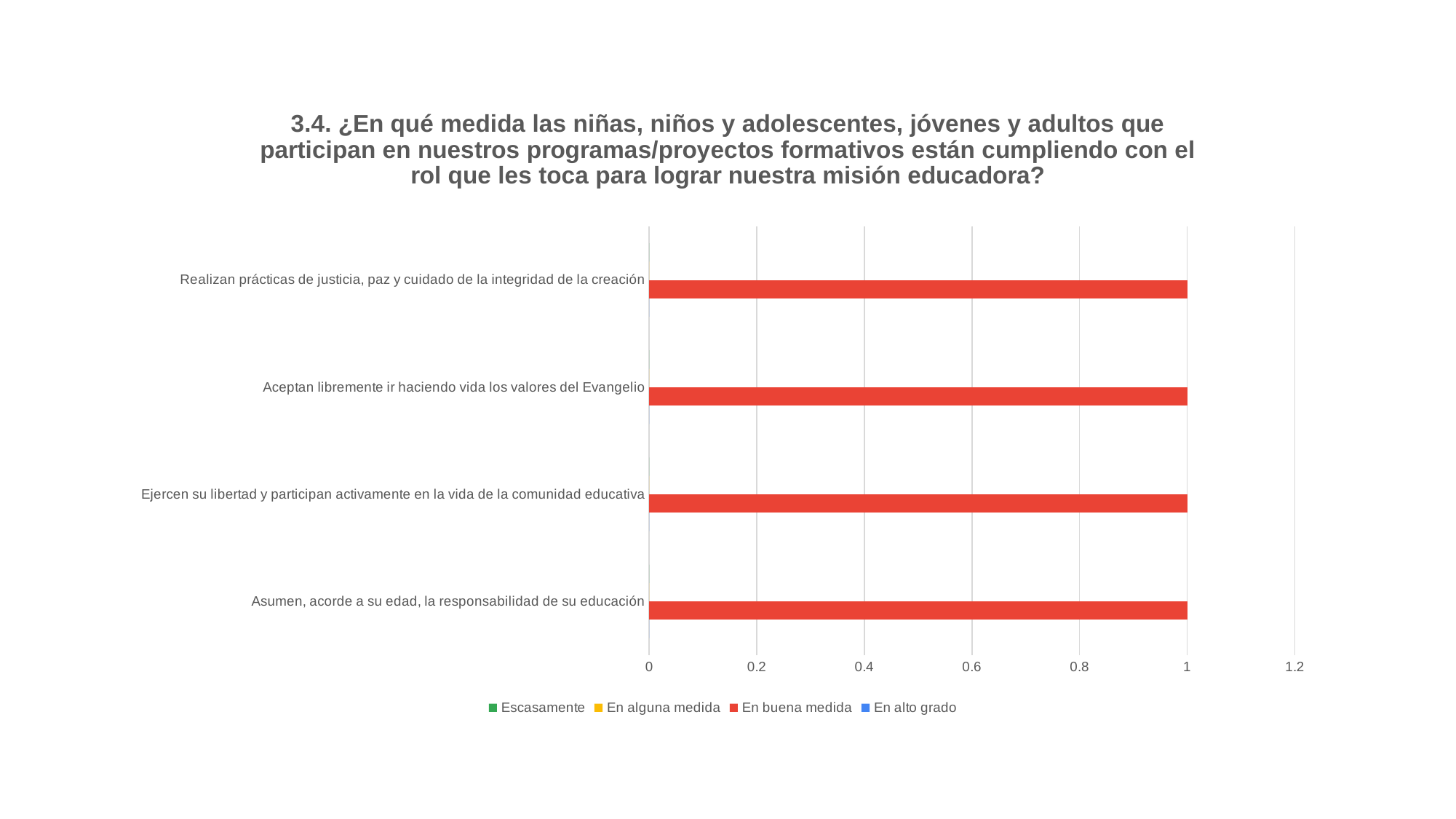
What is the value of "En buena medida" for "Aceptan libremente ir haciendo vida los valores del Evangelio"? 1 Is the "En buena medida" value for "Ejercen su libertad y participan activamente en la vida de la comunidad educativa" greater or less than 0.8? greater Is the "En buena medida" value for "Aceptan libremente ir haciendo vida los valores del Evangelio" greater or less than 0.6? greater How many series does the legend list? 4 What is the difference between the "En buena medida" values for "Realizan prácticas de justicia, paz y cuidado de la integridad de la creación" and "Asumen, acorde a su edad, la responsabilidad de su educación"? 0 How many categories are plotted on the chart? 4 What is the value of "En buena medida" for "Realizan prácticas de justicia, paz y cuidado de la integridad de la creación"? 1 What is the highest value shown on the horizontal axis? 1.2 What is the value of "En buena medida" for "Asumen, acorde a su edad, la responsabilidad de su educación"? 1 What is the value of "En buena medida" for "Ejercen su libertad y participan activamente en la vida de la comunidad educativa"? 1 What kind of chart is shown on the slide? bar chart Which series is shown in red in the legend? En buena medida